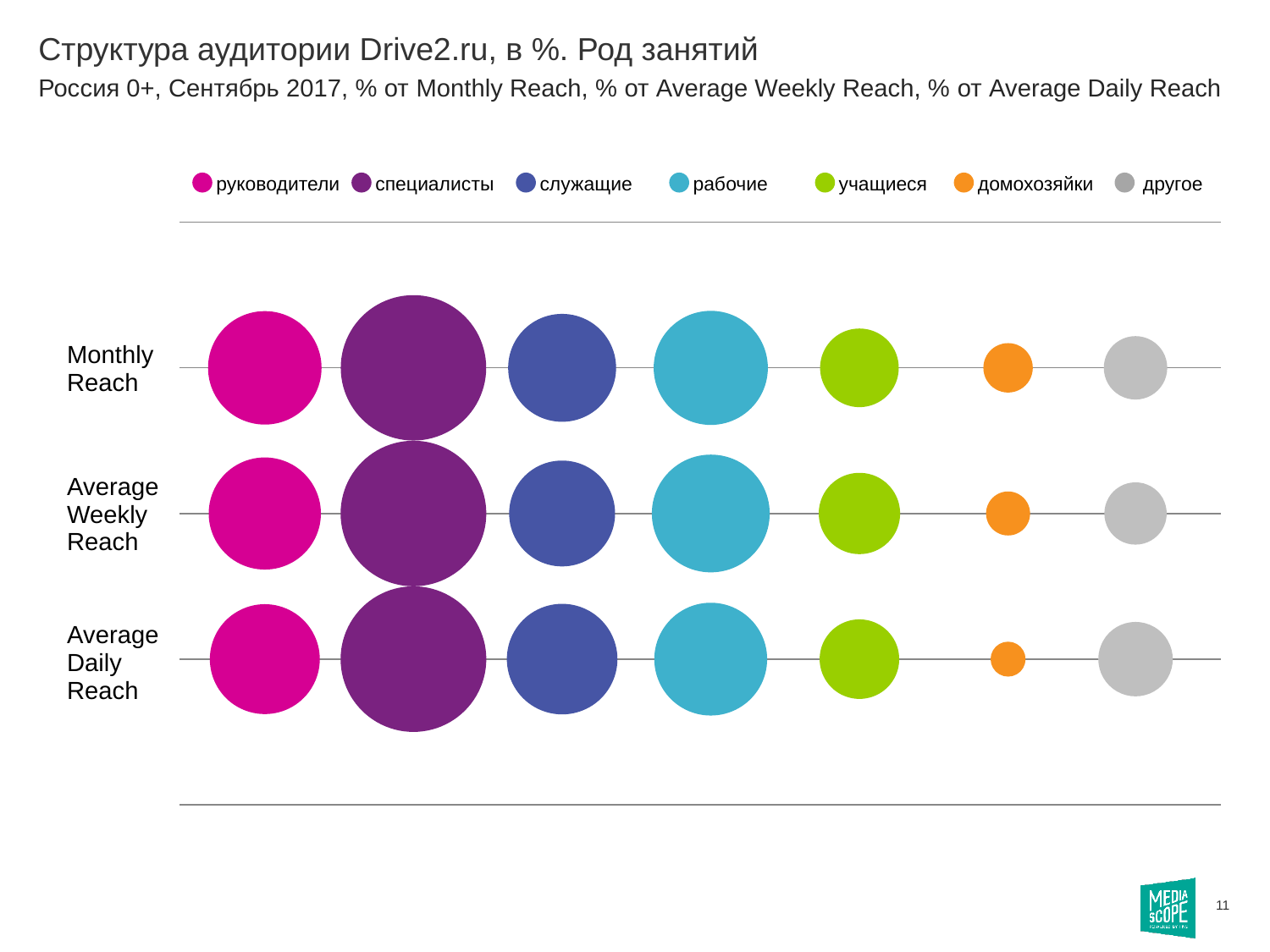
What kind of chart is shown on the slide? bubble chart What is the title of the chart on the slide? Структура аудитории Drive2.ru, в %. Род занятий In the Monthly Reach row, which bubble is larger: рабочие or домохозяйки? рабочие Which occupation category has the smallest bubble in the Average Daily Reach row? домохозяйки In the Average Weekly Reach row, which bubble is larger: специалисты or учащиеся? специалисты How many reach rows (Monthly, Weekly, Daily) are plotted in the chart? 3 Which colour represents the category 'рабочие' in the legend? light blue Which occupation category has the largest bubble in the Average Daily Reach row? специалисты In the Average Daily Reach row, which bubble is larger: руководители or другое? руководители Which occupation category has the largest bubble in the Monthly Reach row? специалисты How many occupation categories does the legend list? 7 Which occupation category has the smallest bubble in the Monthly Reach row? домохозяйки